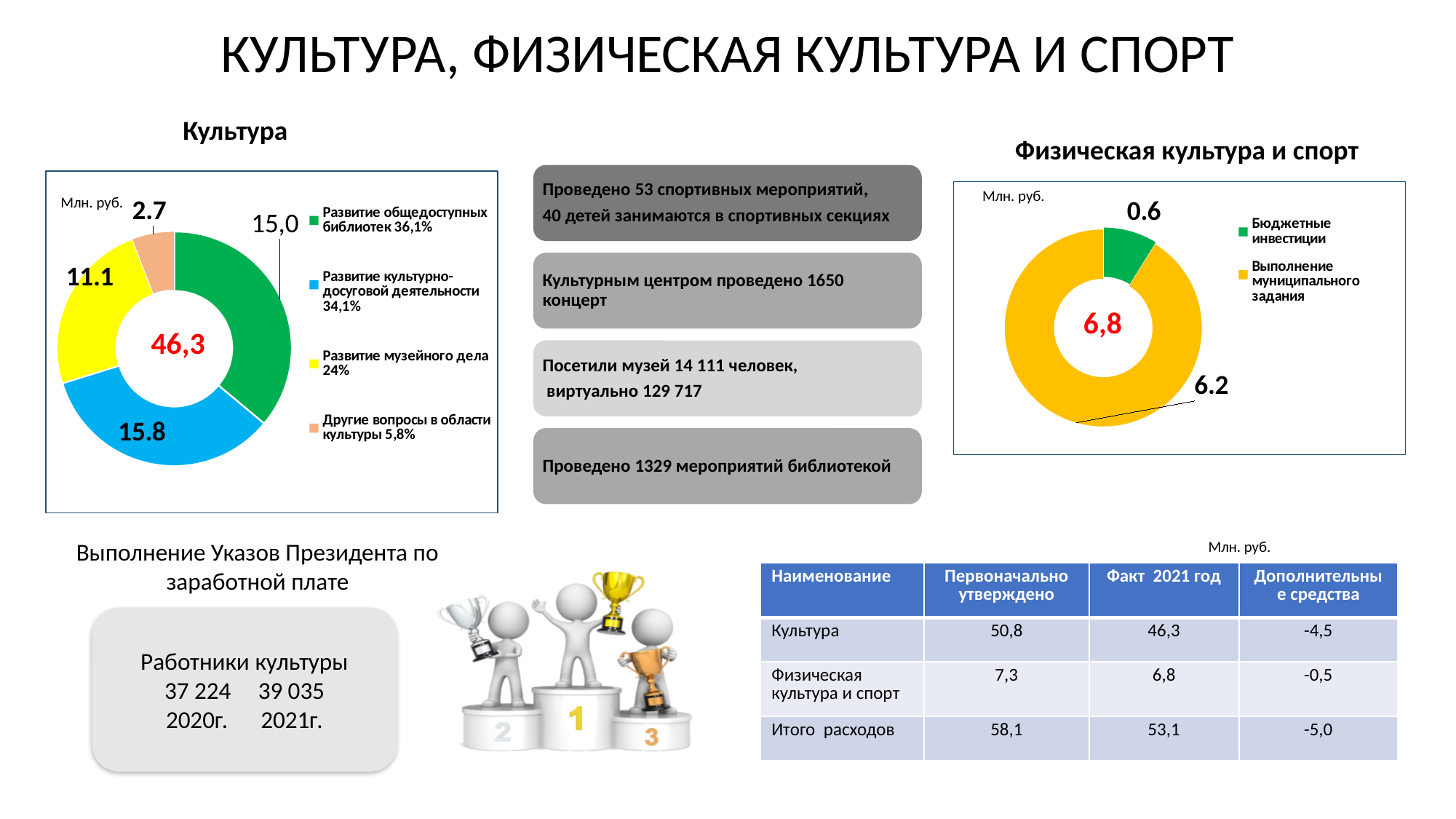
In the Физическая культура и спорт chart, what is the value for Выполнение муниципального задания? 6.2 In the Физическая культура и спорт chart, what is the difference between Выполнение муниципального задания and Бюджетные инвестиции? 5.6 In the Культура chart, what total value is shown in the centre of the donut? 46,3 In the Культура chart, what share does Развитие музейного дела have? 24% How many categories does the Культура chart show? 4 In the Физическая культура и спорт chart, which category has the largest value? Выполнение муниципального задания In the Культура chart, what is the value for Другие вопросы в области культуры? 2.7 In the Культура chart, what is the difference between Развитие музейного дела and Другие вопросы в области культуры? 8.4 In the Культура chart, what is the value for Развитие музейного дела? 11.1 In the Культура chart, which category has the smallest value? Другие вопросы в области культуры In the Физическая культура и спорт chart, what is the value for Бюджетные инвестиции? 0.6 What type of chart is the Физическая культура и спорт chart? Pie (donut) chart